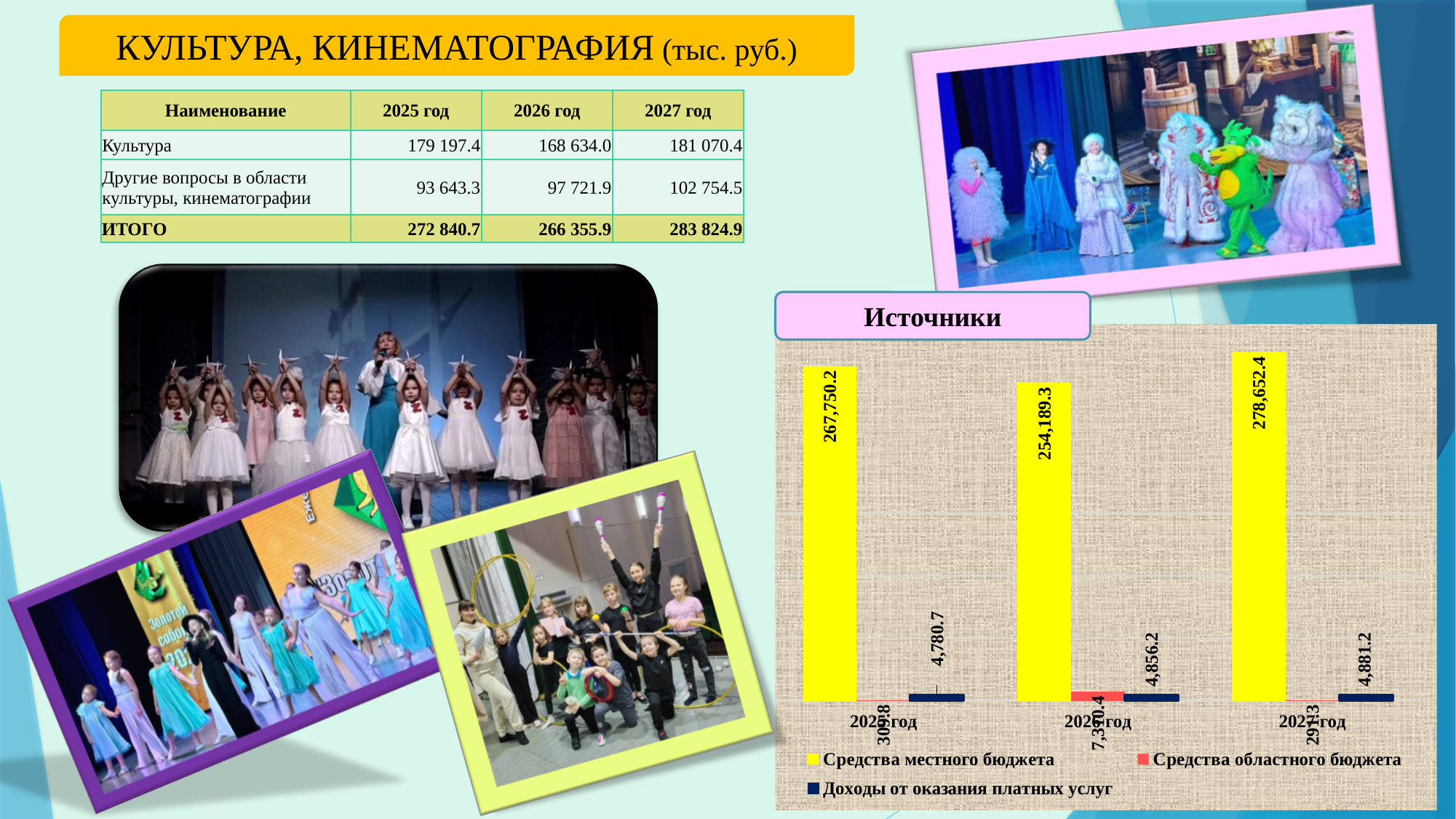
In the "Источники" chart, what is the value of "Средства местного бюджета" for 2027 год? 278,652.4 In the "Источники" chart, which is larger: "Доходы от оказания платных услуг" in 2025 год or in 2027 год? 2027 год What kind of chart is shown under the heading "Источники"? bar chart In the "Источники" chart, by how much does "Средства местного бюджета" in 2027 год exceed that in 2025 год? 10,902.2 In the "Источники" chart, which year has the highest value for "Средства местного бюджета"? 2027 год In the "Источники" chart, do the values for "Доходы от оказания платных услуг" rise or fall from 2025 to 2027? rise How many series does the legend of the "Источники" chart list? 3 In the "Источники" chart, which year has the lowest value for "Средства местного бюджета"? 2026 год How many years are shown on the x axis of the "Источники" chart? 3 In the "Источники" chart, what is the difference between "Доходы от оказания платных услуг" in 2027 год and in 2025 год? 100.5 In the "Источники" chart, what is the value of "Доходы от оказания платных услуг" for 2026 год? 4,856.2 In the "Источники" chart, what is the value of "Средства местного бюджета" for 2025 год? 267,750.2